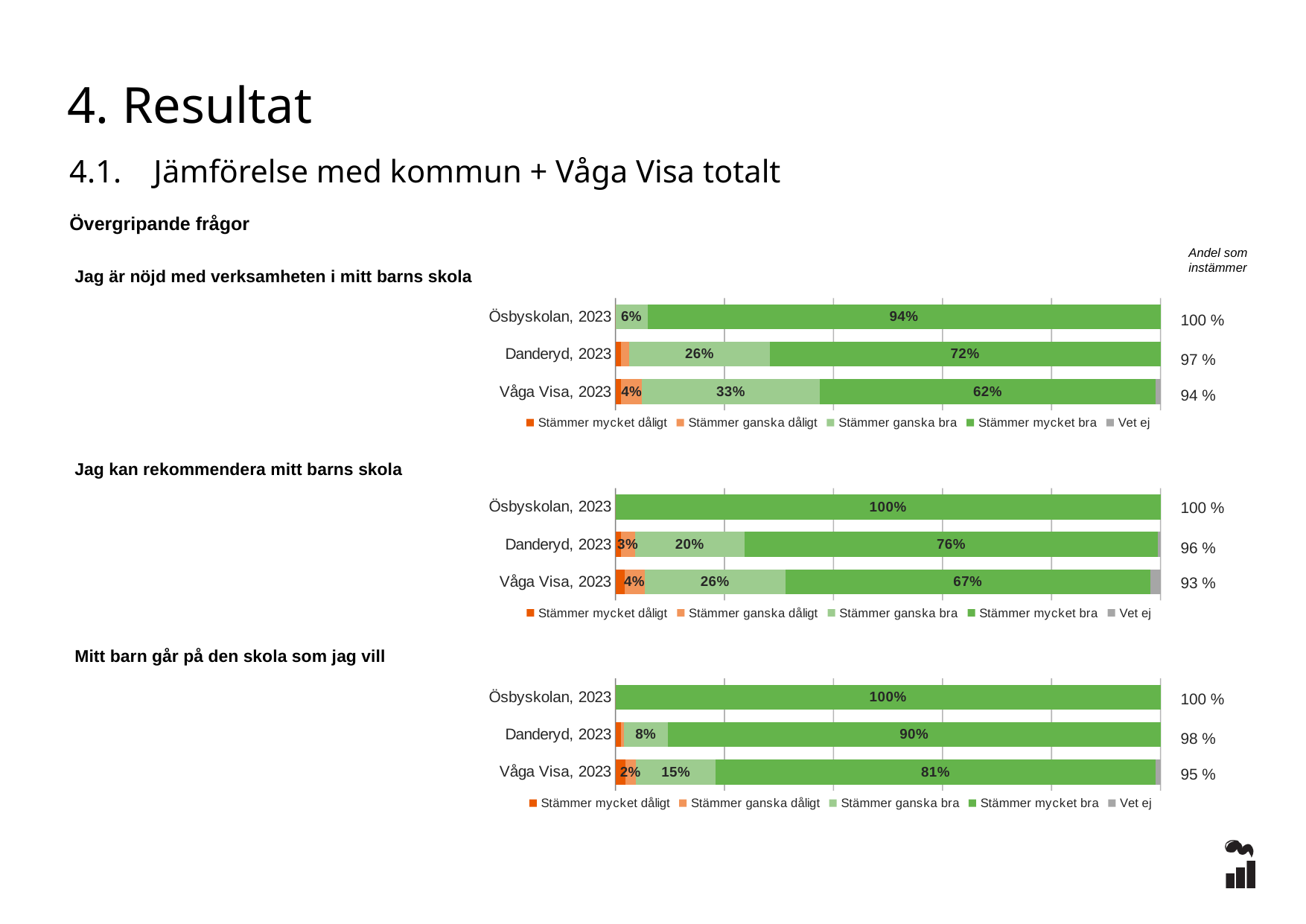
How many series does the legend list for the chart 'Jag kan rekommendera mitt barns skola'? 5 In the chart 'Mitt barn går på den skola som jag vill', is the 'Stämmer mycket bra' value for Danderyd, 2023 larger or smaller than that for Våga Visa, 2023? larger In the chart 'Jag är nöjd med verksamheten i mitt barns skola', what is the 'Stämmer ganska bra' value for Våga Visa, 2023? 33% How many rows (categories) are shown in the chart 'Mitt barn går på den skola som jag vill'? 3 In the chart 'Jag kan rekommendera mitt barns skola', what is the 'Stämmer mycket bra' value for Danderyd, 2023? 76% What kind of chart is used for 'Jag är nöjd med verksamheten i mitt barns skola'? Stacked bar chart In the chart 'Jag kan rekommendera mitt barns skola', what is the 'Andel som instämmer' value shown for Våga Visa, 2023? 93 % In the chart 'Jag kan rekommendera mitt barns skola', which row has the lowest 'Stämmer mycket bra' value? Våga Visa, 2023 In the chart 'Jag är nöjd med verksamheten i mitt barns skola', what is the 'Stämmer mycket bra' value for Ösbyskolan, 2023? 94% In the chart 'Jag är nöjd med verksamheten i mitt barns skola', which row has the highest 'Stämmer mycket bra' value? Ösbyskolan, 2023 In the chart 'Mitt barn går på den skola som jag vill', what is the 'Stämmer ganska bra' value for Danderyd, 2023? 8% In the chart 'Jag är nöjd med verksamheten i mitt barns skola', what is the difference between the 'Stämmer mycket bra' values for Danderyd, 2023 and Våga Visa, 2023? 10 percentage points